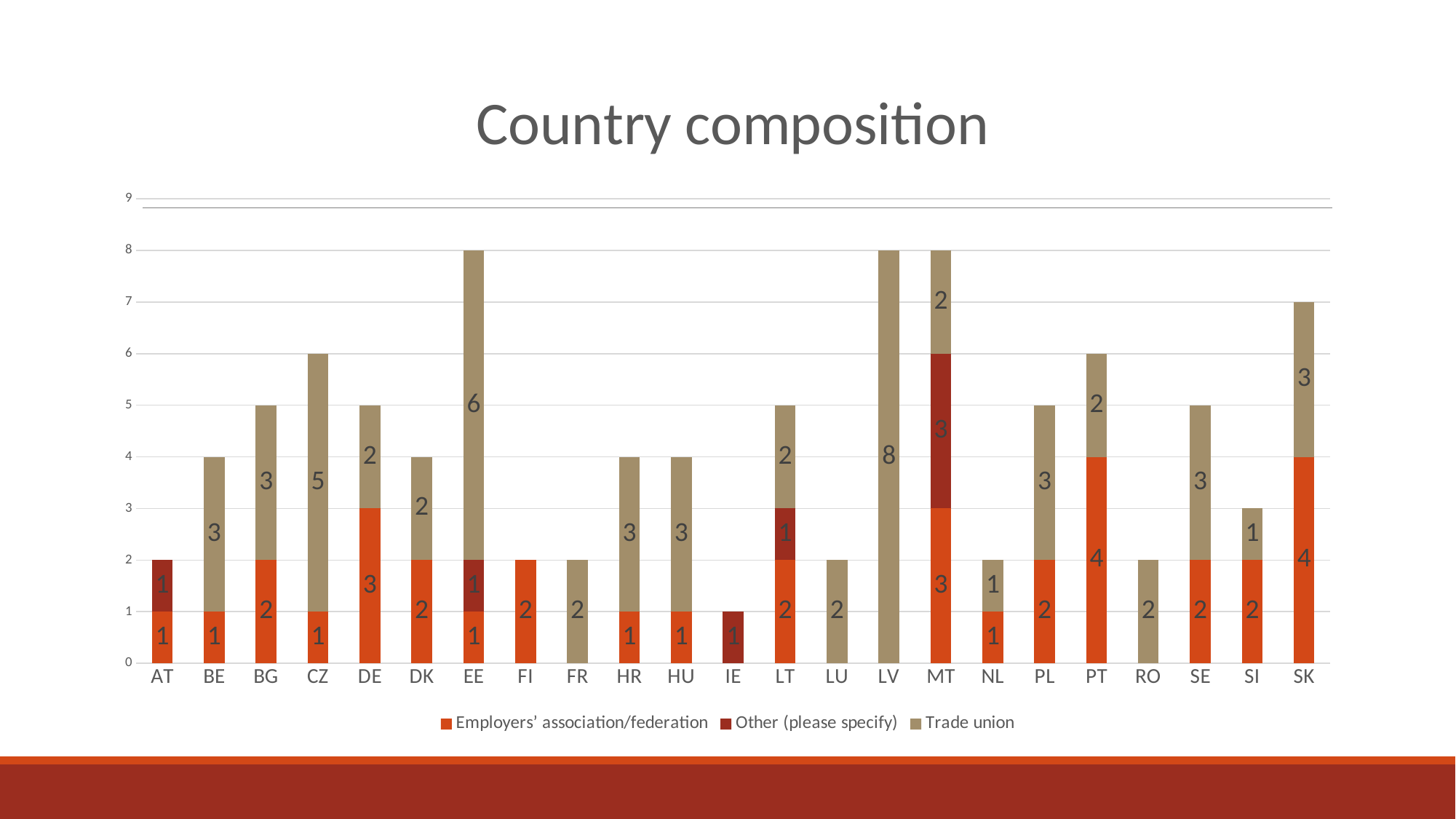
What is the difference between the Trade union values for CZ and DE? 3 What is the total of the stacked bar for SK? 7 How many countries are shown on the x axis? 23 What is the Employers' association/federation value for PT? 4 What type of chart is shown on the slide? stacked bar chart What is the Other (please specify) value for MT? 3 What is the total of the stacked bar for MT? 8 How many series does the legend list? 3 Which is larger, the Employers' association/federation value for DE or for DK? DE Which country has the highest Trade union value? LV What is the Trade union value for LV? 8 Which country has the lowest total bar? IE